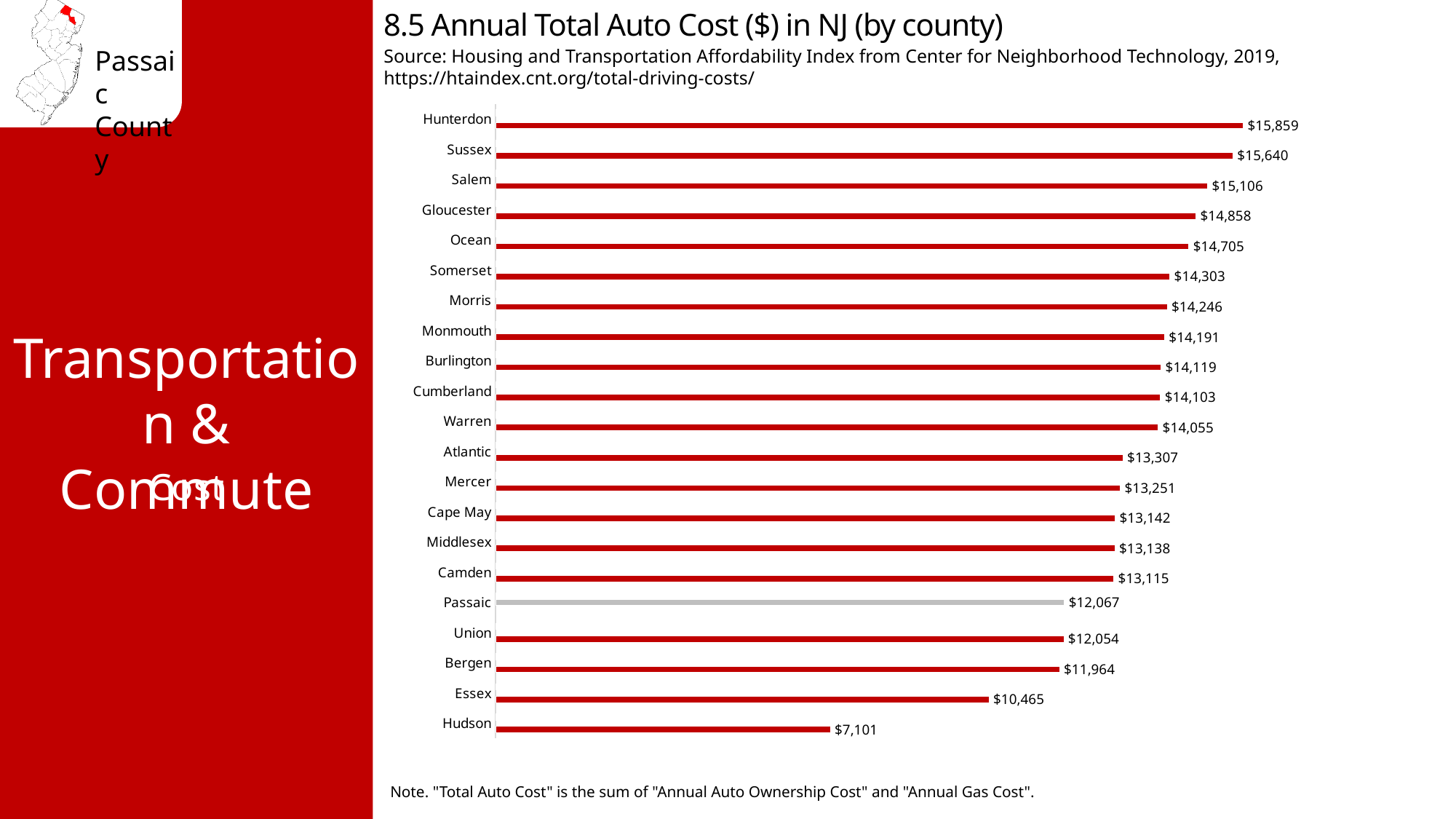
Which county has a higher annual total auto cost, Bergen or Essex? Bergen What kind of chart is shown on the slide? Bar chart Do the values rise or fall going from the top of the chart to the bottom? Fall Which county's bar is shown in a different colour (grey) from the others? Passaic What is the annual total auto cost for Essex county? $10,465 Which county has the highest annual total auto cost? Hunterdon Which county has the lowest annual total auto cost? Hudson What is the annual total auto cost for Hunterdon county? $15,859 How many counties are shown in the chart? 21 What is the annual total auto cost for Passaic county? $12,067 What is the difference in annual total auto cost between Hunterdon and Hudson counties? $8,758 What is the difference in annual total auto cost between Passaic and Union counties? $13